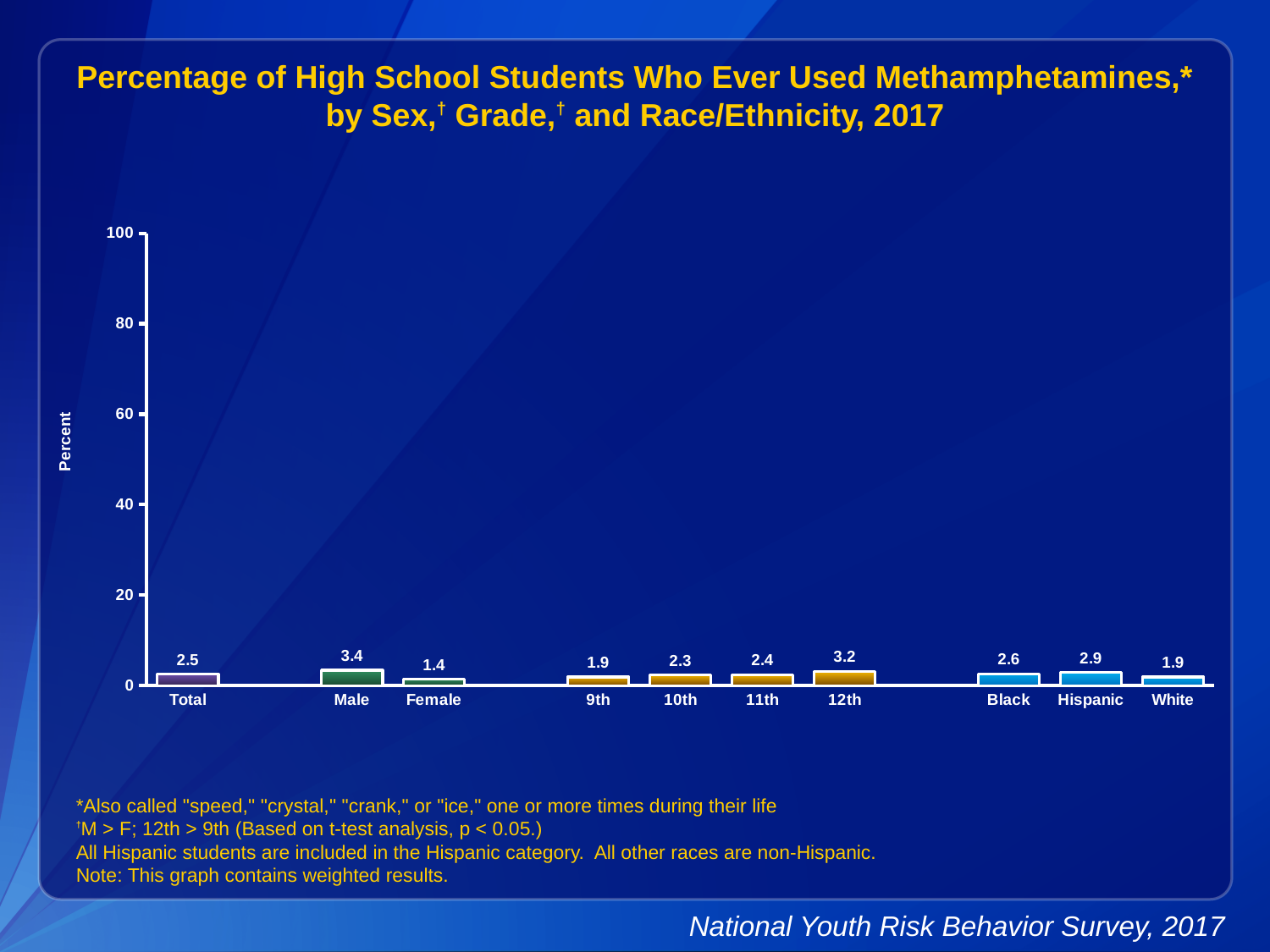
What is the value for Male? 3.4 How many categories are shown on the x axis? 10 Which category has the highest value? Male What is the value for Female? 1.4 Do the values rise or fall from 9th grade to 12th grade? rise Which category has the lowest value? Female What is the difference between the values for Male and Female? 2.0 What kind of chart is this? bar chart Is the value for Total greater or less than 20? less What is the value for Hispanic? 2.9 What is the value for 12th grade? 3.2 Which is larger, the value for 12th grade or the value for 9th grade? 12th